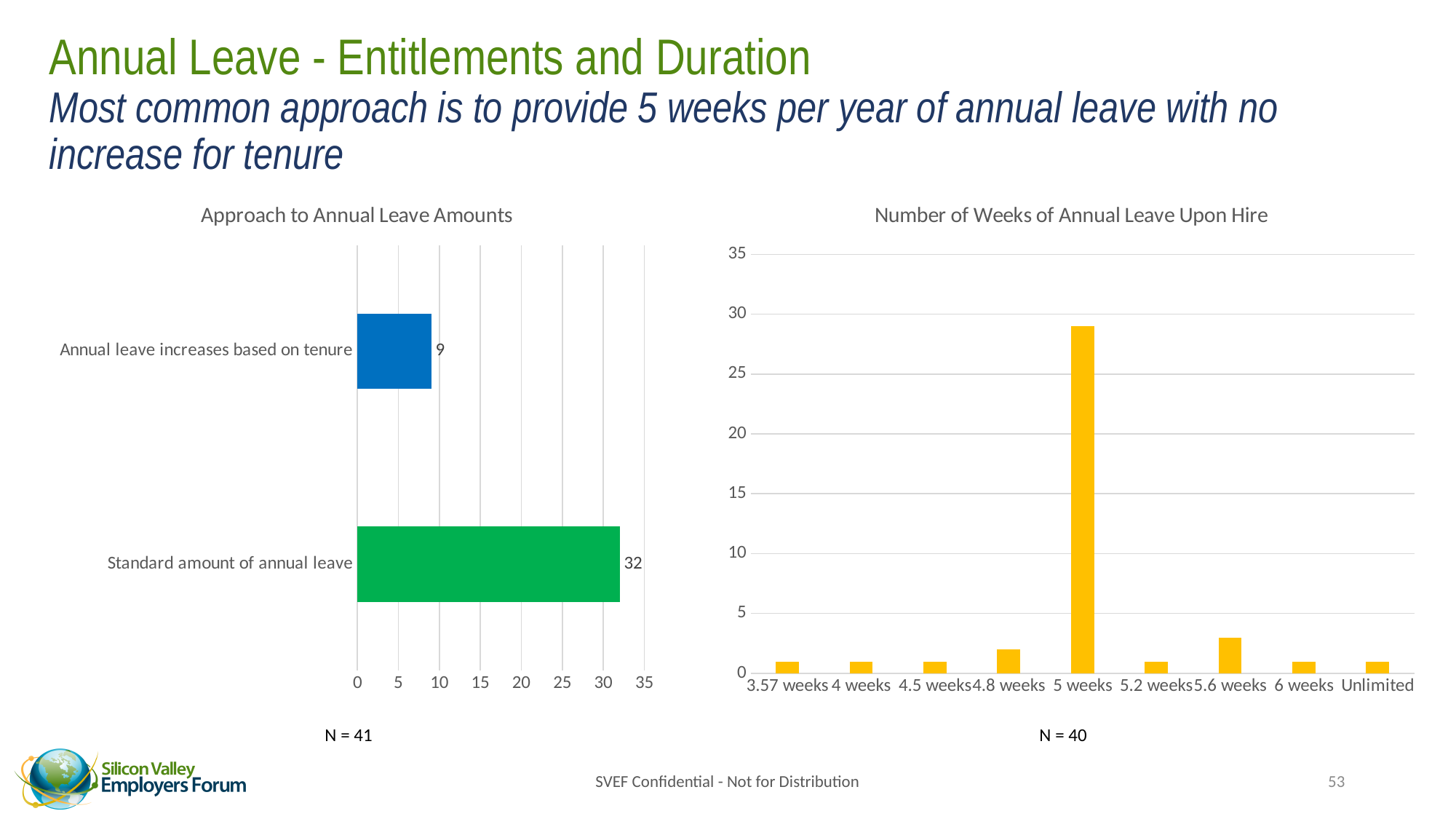
In the 'Approach to Annual Leave Amounts' chart, what is the value for 'Annual leave increases based on tenure'? 9 How many categories are shown in the 'Approach to Annual Leave Amounts' chart? 2 In the 'Number of Weeks of Annual Leave Upon Hire' chart, is the value for '4 weeks' greater or less than 5? less In the 'Approach to Annual Leave Amounts' chart, what is the value for 'Standard amount of annual leave'? 32 What is the title of the chart on the right side of the slide? Number of Weeks of Annual Leave Upon Hire In the 'Approach to Annual Leave Amounts' chart, which category has the highest value? Standard amount of annual leave In the 'Approach to Annual Leave Amounts' chart, what is the difference between 'Standard amount of annual leave' and 'Annual leave increases based on tenure'? 23 In the 'Number of Weeks of Annual Leave Upon Hire' chart, which category has the highest value? 5 weeks In the 'Number of Weeks of Annual Leave Upon Hire' chart, which is larger: the value for '5 weeks' or the value for '6 weeks'? 5 weeks In the 'Number of Weeks of Annual Leave Upon Hire' chart, is the value for '5 weeks' greater or less than 25? greater How many categories are shown on the x axis of the 'Number of Weeks of Annual Leave Upon Hire' chart? 9 What kind of chart is the 'Approach to Annual Leave Amounts' chart? Bar chart